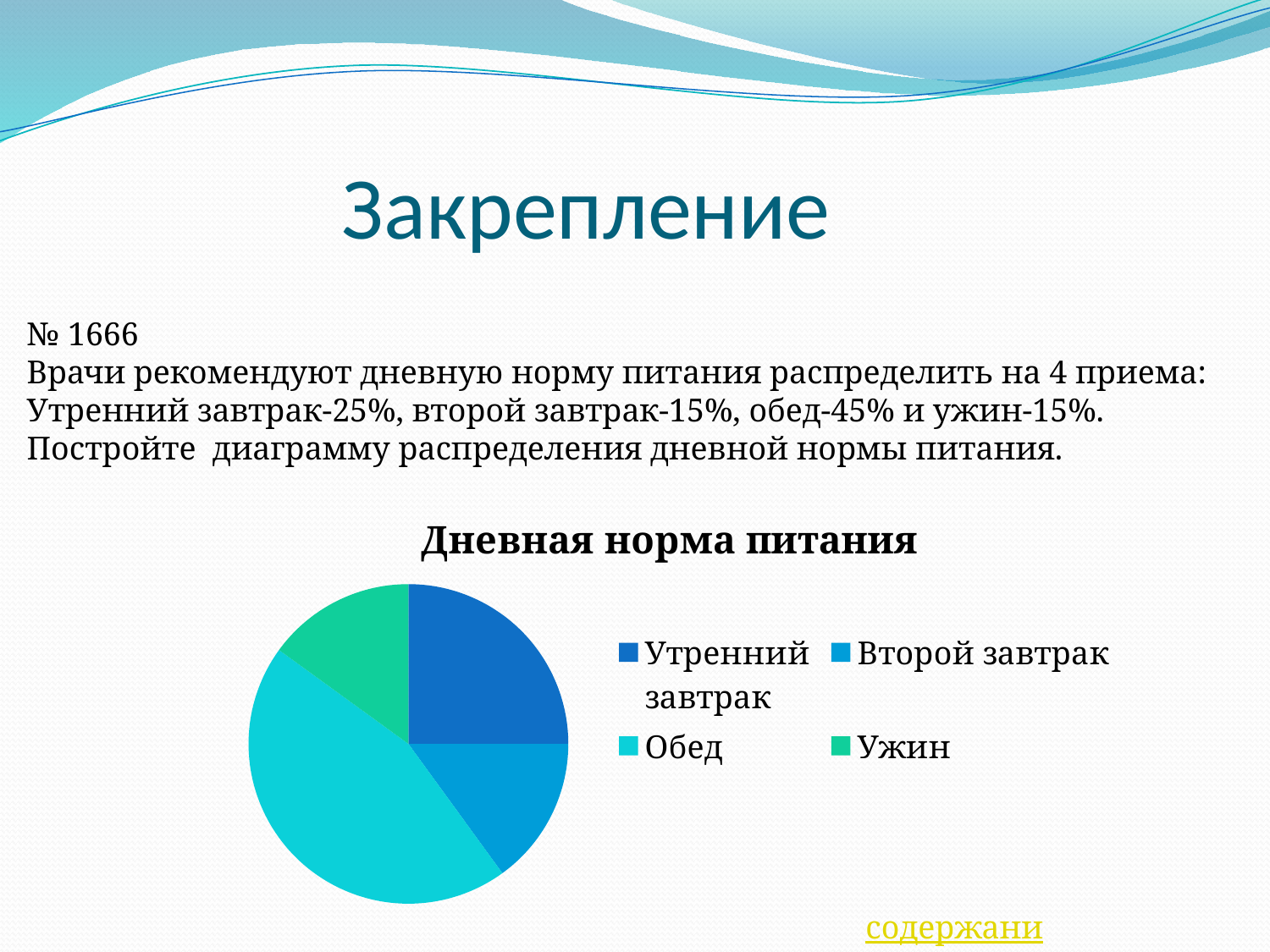
Which slice is larger, Обед or Второй завтрак? Обед Which slice is larger, Утренний завтрак or Ужин? Утренний завтрак What share of the daily food intake does Утренний завтрак represent? 25% What is the difference between the shares of Обед and Утренний завтрак? 20% Which meal has the largest slice of the pie chart? Обед How many entries does the chart legend list? 4 What kind of chart is shown on the slide? pie chart What share of the daily food intake does Обед represent? 45% Which legend entry is shown in dark blue? Утренний завтрак What share of the daily food intake does Ужин represent? 15% What is the title of the chart? Дневная норма питания How many slices does the pie chart have? 4